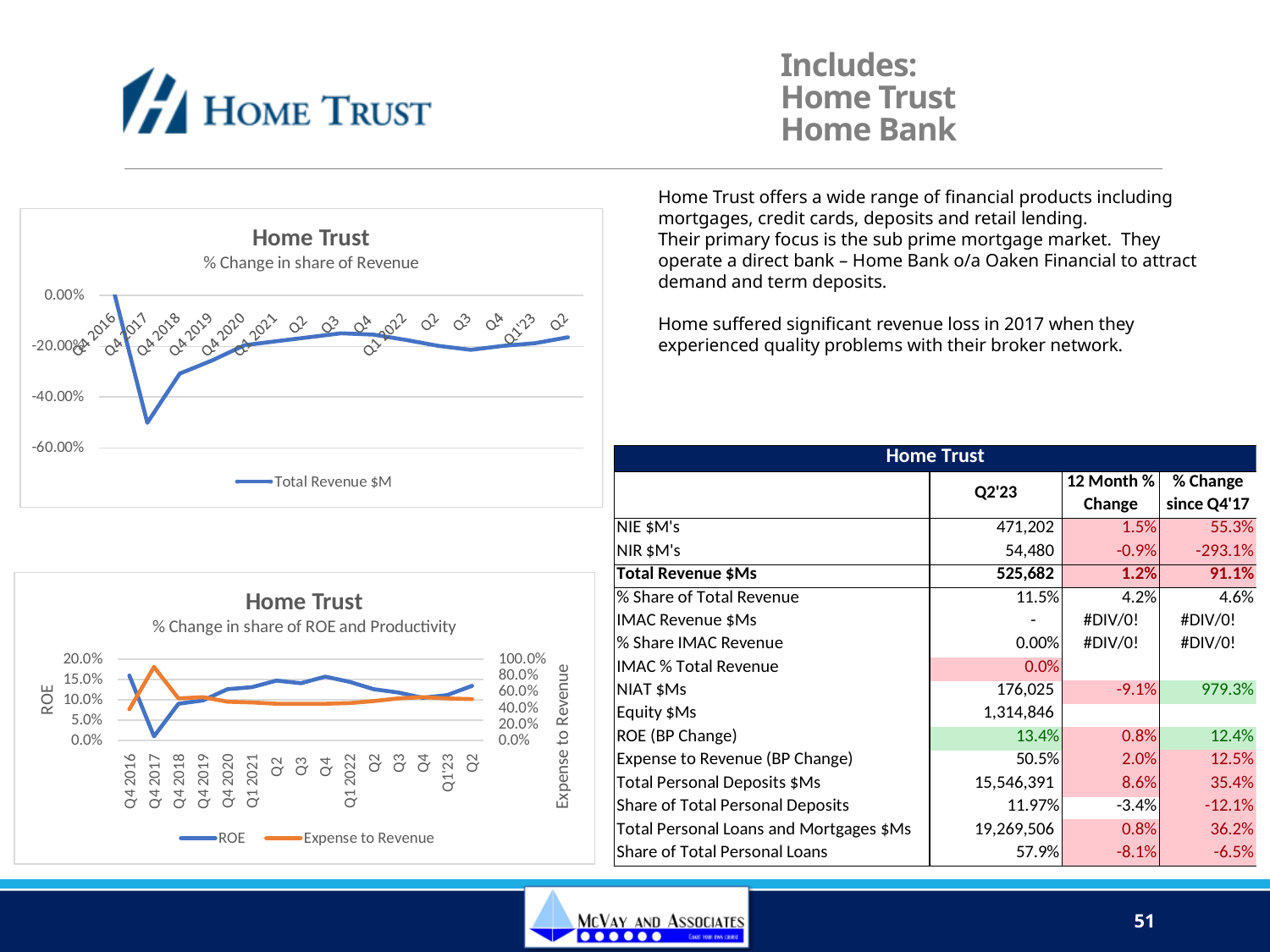
In the top chart (% Change in share of Revenue), is the value for Q4 2017 greater or less than -40.00%? less In the bottom chart (% Change in share of ROE and Productivity), how many series does the legend list? 2 In the bottom chart (% Change in share of ROE and Productivity), is the ROE value for Q4 2017 greater or less than 5.0%? less In the top chart (% Change in share of Revenue), how many periods are plotted along the x axis? 15 In the top chart (% Change in share of Revenue), is the value for Q4 2020 greater or less than -40.00%? greater In the bottom chart (% Change in share of ROE and Productivity), what is the label of the right-hand vertical axis? Expense to Revenue In the bottom chart (% Change in share of ROE and Productivity), which period has the lowest ROE value? Q4 2017 In the top chart (% Change in share of Revenue), how many series does the legend list? 1 In the top chart (% Change in share of Revenue), which period has the lowest value? Q4 2017 What kind of chart is the top chart titled 'Home Trust % Change in share of Revenue'? line chart In the top chart (% Change in share of Revenue), what is the name of the series shown in the legend? Total Revenue $M In the bottom chart (% Change in share of ROE and Productivity), which period has the highest Expense to Revenue value? Q4 2017